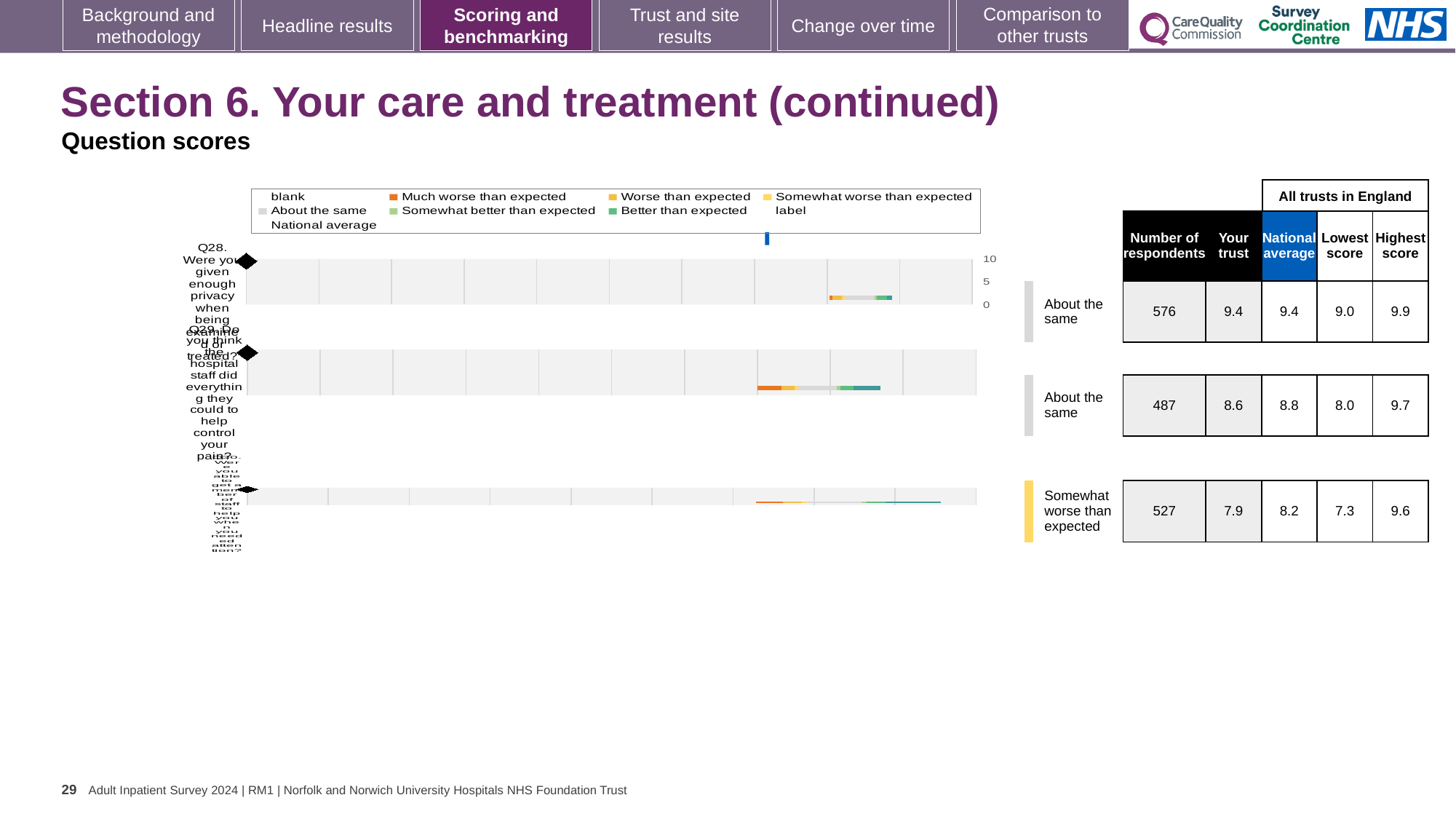
What benchmark category is shown for the third question row (Q30)? Somewhat worse than expected For Q29, which is larger: the 'Your trust' score or the national average? National average What is the 'Your trust' score for Q28 (Were you given enough privacy when being examined or treated?)? 9.4 How many respondents answered Q28? 576 Which question has the lowest number of respondents? Q29 What is the highest score among all trusts in England for the third question row (Q30)? 9.6 How many survey questions are plotted in the chart? 3 What kind of chart is shown on the slide? bar chart What is the national average score for Q29 (Do you think the hospital staff did everything they could to help control your pain?)? 8.8 Which question has the highest 'Your trust' score? Q28 Is the 'Your trust' score for Q28 greater or less than 5 on the chart axis? greater For Q29, what is the difference between the highest score and the lowest score among all trusts in England? 1.7